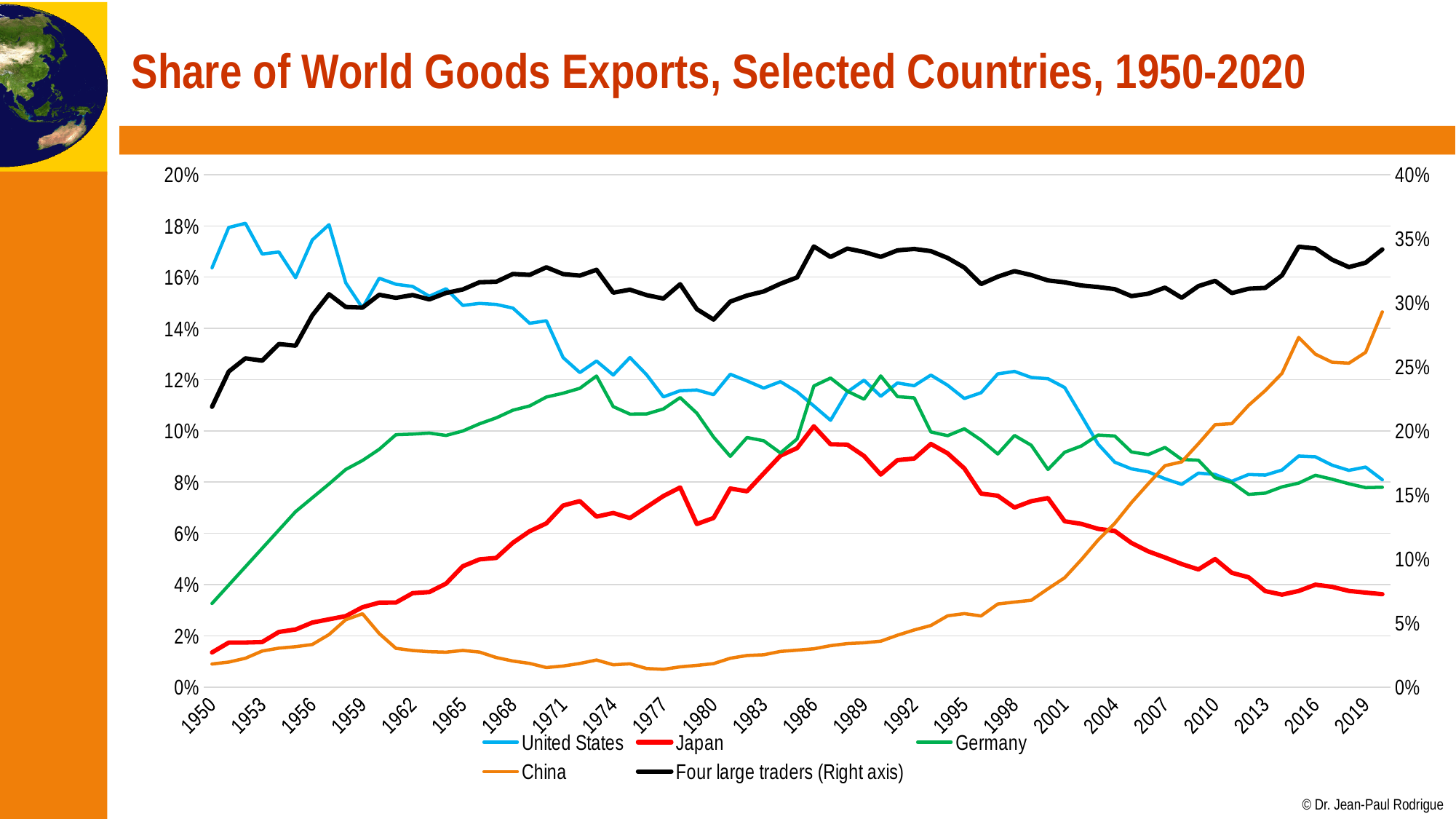
Which series is plotted against the right axis? Four large traders Is the value for China in 2019 greater or less than 12%? greater In 2019, which has the higher share, China or Japan? China Does China's share rise or fall from 2001 to 2019? rise What kind of chart is shown on the slide? line chart Is the value for the United States in 1950 greater or less than 14%? greater Is the value for Four large traders in 2019 greater or less than 30% on the right axis? greater What is the title of the chart? Share of World Goods Exports, Selected Countries, 1950-2020 Among the four countries, which has the lowest share in 2019? Japan How many series does the legend list? 5 Does Japan's share rise or fall from 1995 to 2019? fall